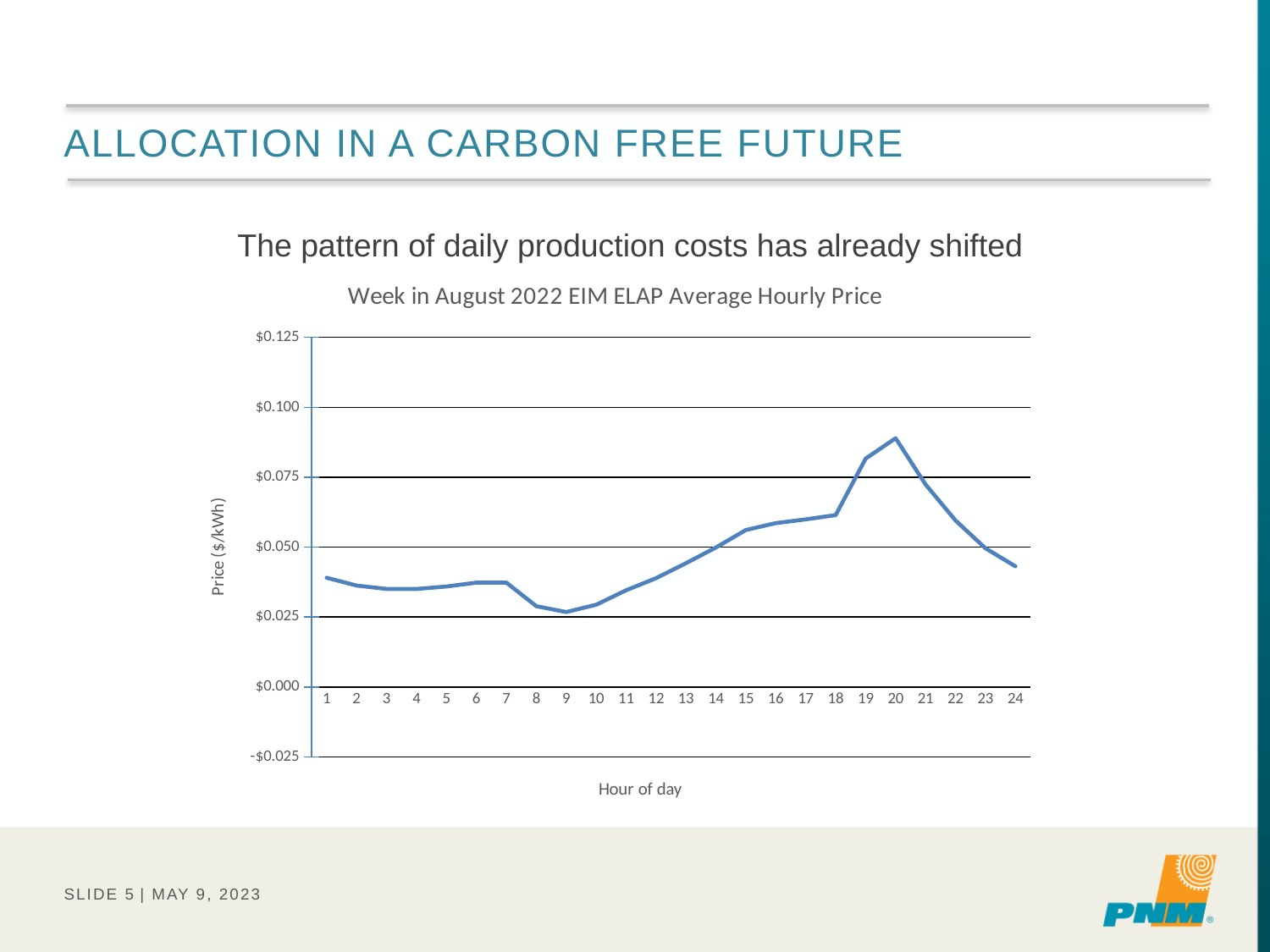
Is the value for hour 9 greater or less than $0.050? less Does the price rise or fall from hour 20 to hour 24? fall Is the value for hour 20 greater or less than $0.075? greater Is the value for hour 1 greater or less than $0.050? less At which hour of the day is the average hourly price lowest? 9 At which hour of the day is the average hourly price highest? 20 Which hour has the larger value, hour 19 or hour 12? 19 What kind of chart is shown on the slide? line chart How many hours of the day are plotted on the x axis? 24 What is the title of the chart? Week in August 2022 EIM ELAP Average Hourly Price What is the label of the vertical axis? Price ($/kWh)